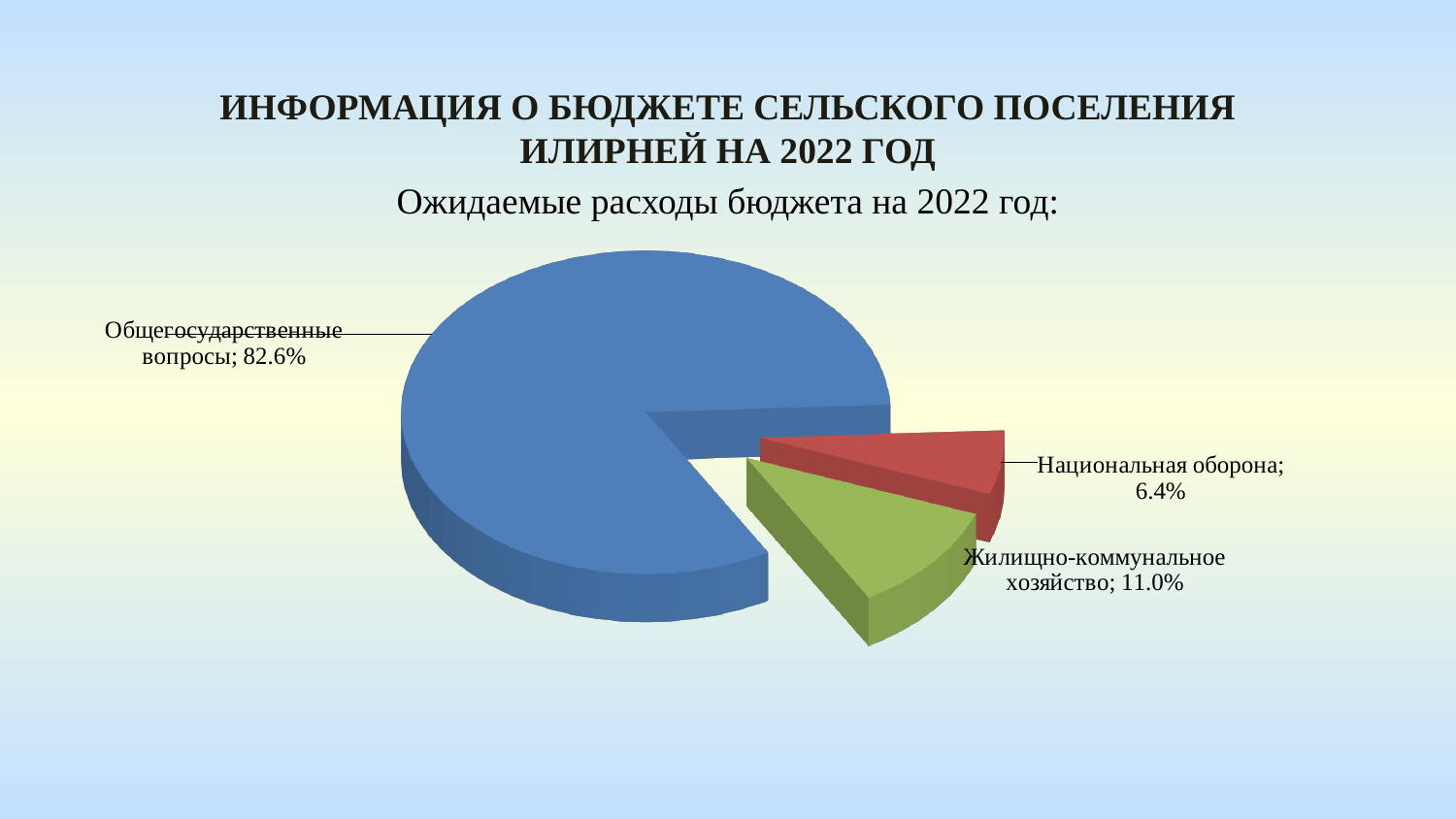
What is the subtitle above the chart? Ожидаемые расходы бюджета на 2022 год: What colour is the slice for Национальная оборона? Red What share of the pie does Общегосударственные вопросы have? 82.6% How many slices does the pie chart have? 3 Which is larger, Жилищно-коммунальное хозяйство or Национальная оборона? Жилищно-коммунальное хозяйство Which category has the largest slice of the pie? Общегосударственные вопросы What is the value shown for Национальная оборона? 6.4% What is the value shown for Жилищно-коммунальное хозяйство? 11.0% What is the difference between the shares of Общегосударственные вопросы and Жилищно-коммунальное хозяйство? 71.6% What kind of chart is shown on the slide? Pie chart Which category has the smallest slice of the pie? Национальная оборона What is the difference between the shares of Жилищно-коммунальное хозяйство and Национальная оборона? 4.6%